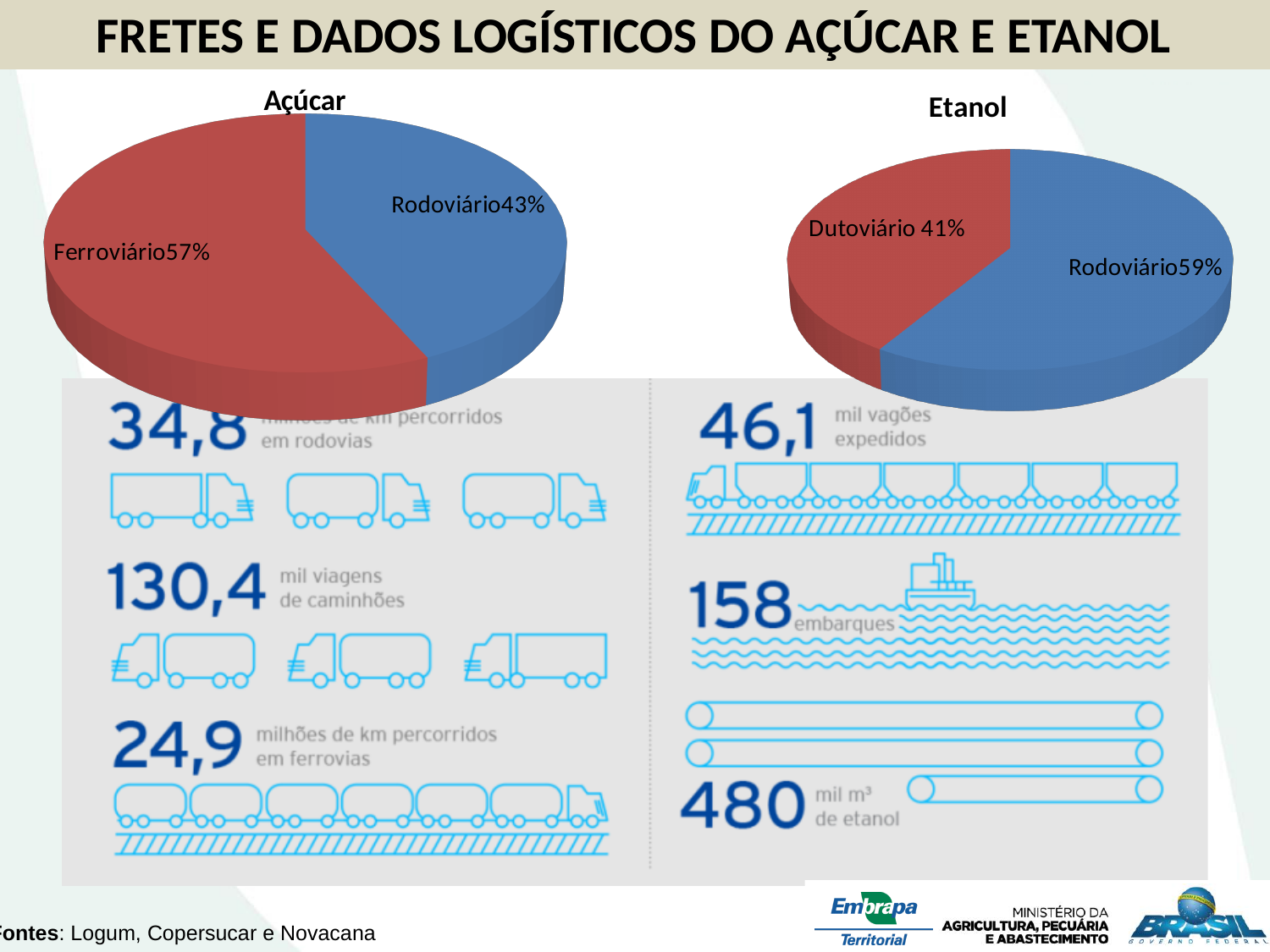
In the Açúcar chart, what share does Ferroviário have? 57% In the Etanol chart, what is the difference in percentage points between Rodoviário and Dutoviário? 18 How many slices does the Açúcar chart have? 2 In the Açúcar chart, what is the difference in percentage points between Ferroviário and Rodoviário? 14 Which is larger: the Rodoviário share in the Açúcar chart or the Rodoviário share in the Etanol chart? Etanol What type of chart is the Etanol chart? Pie chart In the Açúcar chart, which mode has the largest share? Ferroviário In the Açúcar chart, what share does Rodoviário have? 43% In the Etanol chart, which mode has the smallest share? Dutoviário In the Etanol chart, what colour is the Rodoviário slice? Blue In the Etanol chart, what share does Dutoviário have? 41% In the Etanol chart, what share does Rodoviário have? 59%